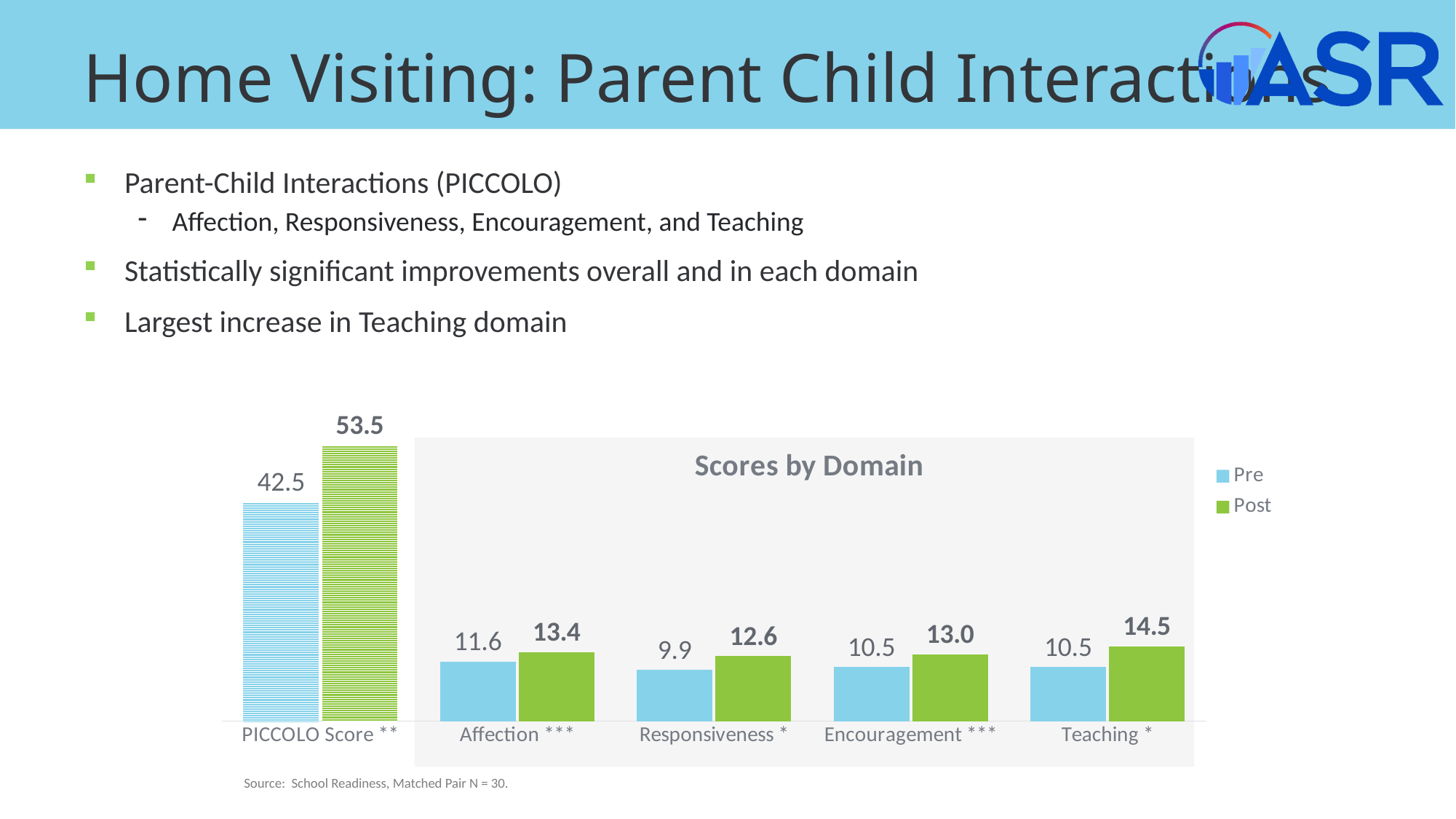
What is the Post value for PICCOLO Score? 53.5 Among the four domains (Affection, Responsiveness, Encouragement, Teaching), which has the highest Post value? Teaching What is the difference between the Post and Pre values for PICCOLO Score? 11.0 What is the Pre value for Responsiveness? 9.9 Which is larger, the Post value for Affection or the Post value for Encouragement? Affection What is the Pre value for Affection? 11.6 What type of chart is shown on the slide? Bar chart How many series does the legend list? 2 What is the difference between the Post and Pre values for Teaching? 4.0 What is the Post value for Teaching? 14.5 How many categories are shown on the x axis of the chart? 5 Which category has the lowest Pre value? Responsiveness